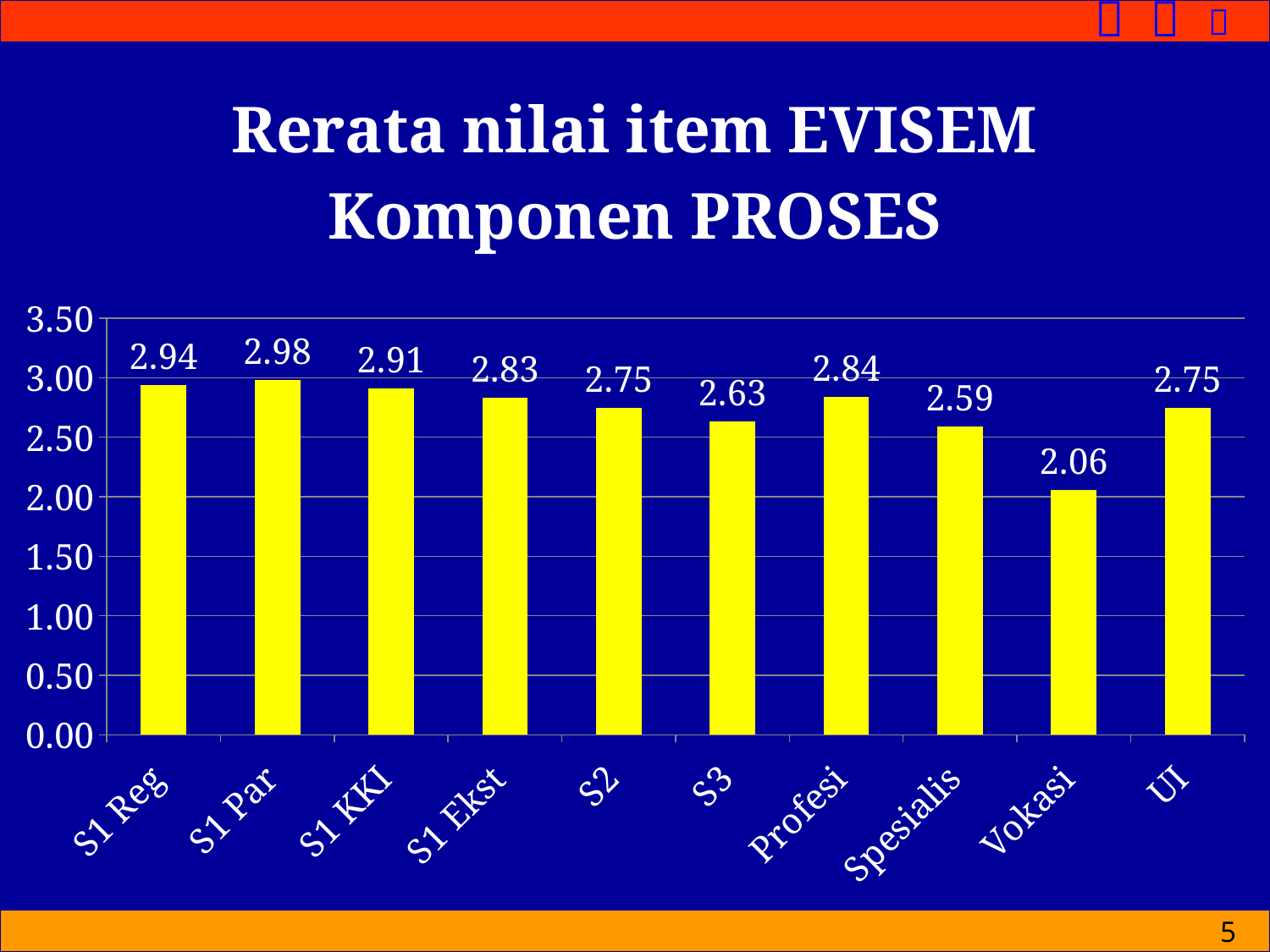
Which category has the lowest value? Vokasi Which is larger, the value for S1 Reg or the value for S3? S1 Reg What is the value for Spesialis? 2.59 What kind of chart is shown on the slide? bar chart Is the value for Vokasi greater or less than 2.50? less What is the value for Vokasi? 2.06 What is the title of the chart? Rerata nilai item EVISEM Komponen PROSES How many categories are shown on the x axis? 10 What is the value for S1 Par? 2.98 What is the difference between the values for S1 Par and Vokasi? 0.92 Which category has the highest value? S1 Par What colour are the bars in the chart? yellow